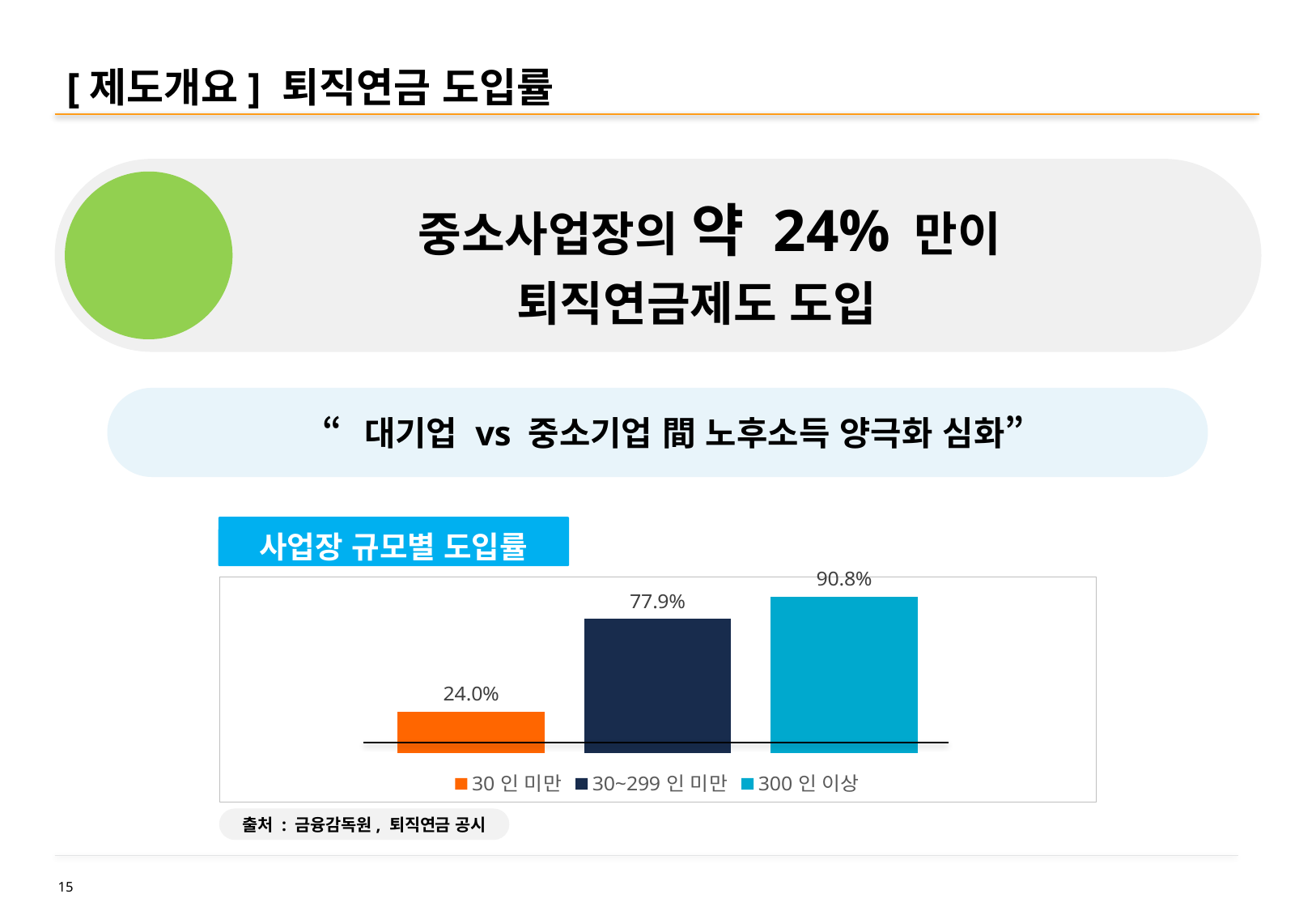
What kind of chart is the 사업장 규모별 도입률 chart? bar chart What is the difference between the adoption rates for 300 인 이상 and 30 인 미만? 66.8% What is the adoption rate for 30~299 인 미만 in the 사업장 규모별 도입률 chart? 77.9% What is the adoption rate for 300 인 이상 in the 사업장 규모별 도입률 chart? 90.8% What is the difference between the adoption rates for 30~299 인 미만 and 30 인 미만? 53.9% What colour is the bar for 30 인 미만 in the 사업장 규모별 도입률 chart? orange Which is larger, the adoption rate for 30~299 인 미만 or for 300 인 이상? 300 인 이상 Which category has the lowest adoption rate in the 사업장 규모별 도입률 chart? 30 인 미만 How many categories are shown in the 사업장 규모별 도입률 chart? 3 What is the adoption rate for 30 인 미만 in the 사업장 규모별 도입률 chart? 24.0% How many entries does the legend of the 사업장 규모별 도입률 chart list? 3 Which category has the highest adoption rate in the 사업장 규모별 도입률 chart? 300 인 이상